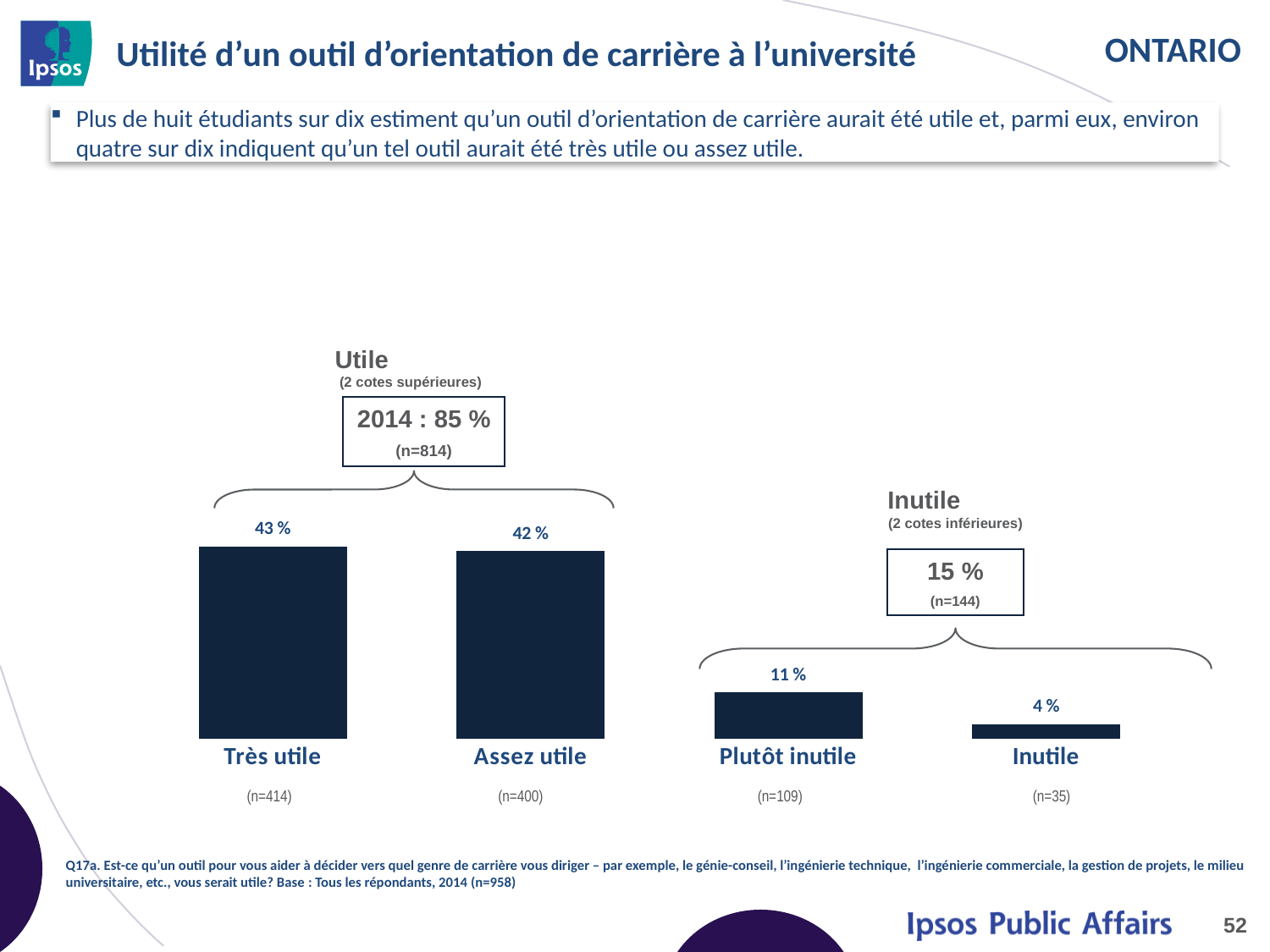
What is the value for Assez utile? 42 % How many categories are shown in the chart? 4 Which category has the lowest value? Inutile What kind of chart is shown on the slide? Bar chart What is the value for Inutile? 4 % What is the difference between the values for Plutôt inutile and Inutile? 7 % What is the value for Plutôt inutile? 11 % What is the value for Très utile? 43 % What is the sample size (n) shown for the Très utile category? n=414 What is the combined value shown for the two 'Utile' categories (2 cotes supérieures) in 2014? 85 % Which is larger, the value for Assez utile or the value for Plutôt inutile? Assez utile Which category has the highest value? Très utile